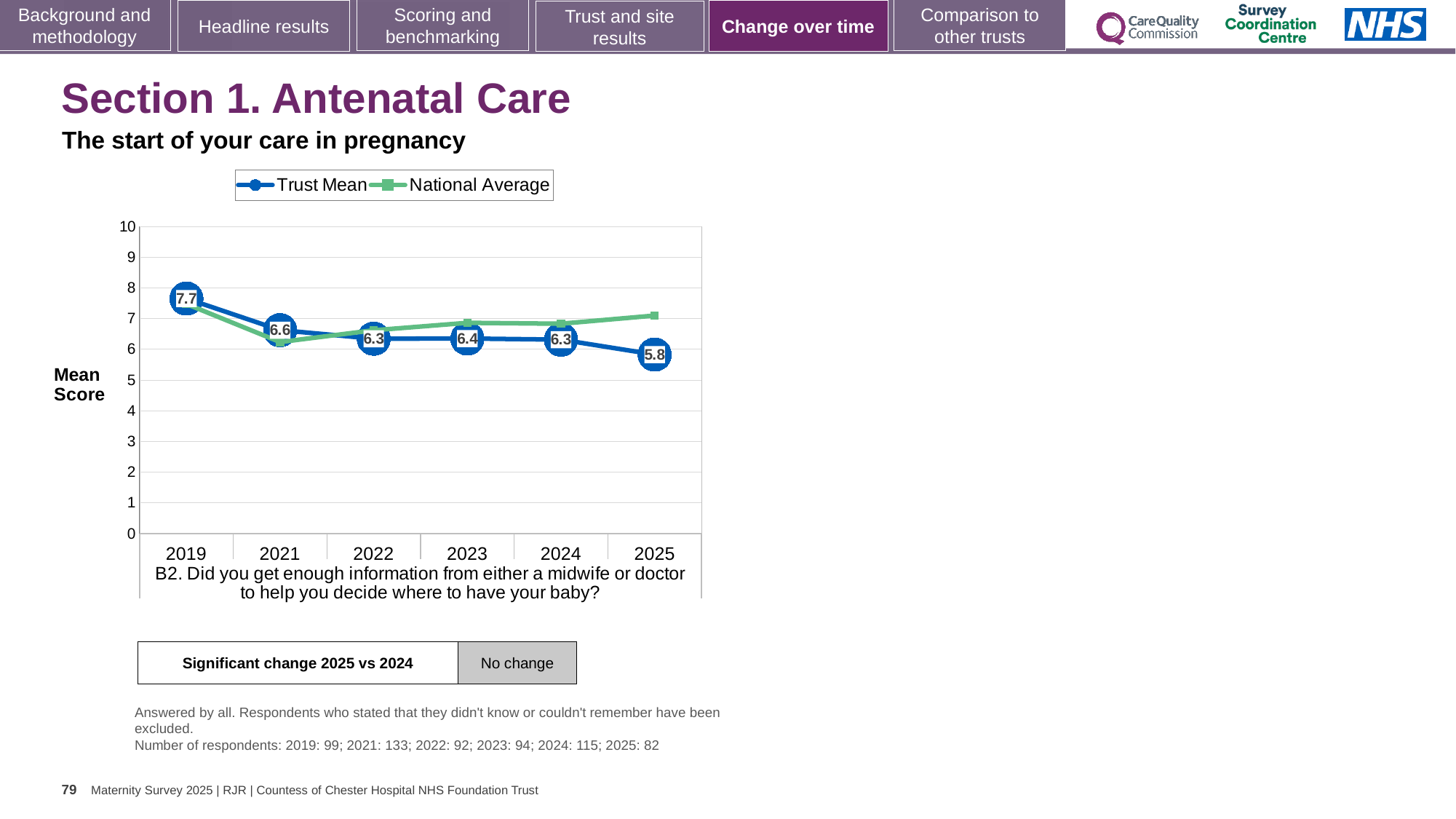
What kind of chart is shown? Line chart How many years are shown on the x axis? 6 What is the Trust Mean score for 2019? 7.7 Is the National Average for 2019 greater or less than 7? greater In which year is the Trust Mean highest? 2019 What is the difference between the Trust Mean in 2019 and in 2025? 1.9 What is the Trust Mean score for 2023? 6.4 In 2025, which is higher: the Trust Mean or the National Average? National Average What is the Trust Mean score for 2025? 5.8 In which year is the Trust Mean lowest? 2025 How many series does the legend list? 2 Does the Trust Mean rise or fall from 2024 to 2025? Fall